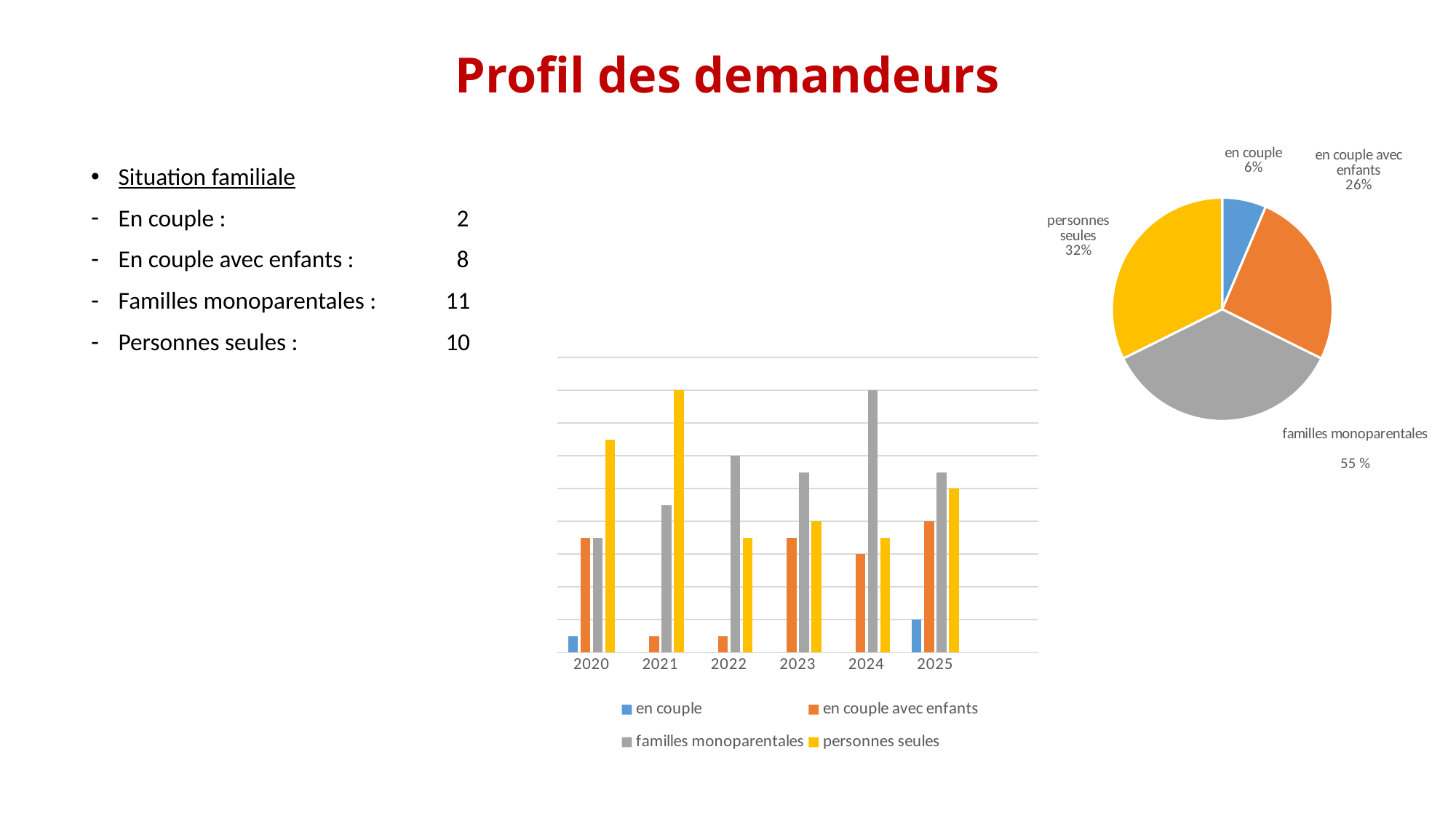
In the bar chart, in 2022, which is larger: 'familles monoparentales' or 'personnes seules'? familles monoparentales In the pie chart, what share is shown for 'en couple'? 6% In the pie chart, which category has the smallest slice? en couple What kind of chart is the chart on the right of the slide? pie chart In the bar chart, which series has the tallest bar in 2021? personnes seules In the bar chart, which series has the tallest bar in 2024? familles monoparentales In the pie chart, what share is shown for 'en couple avec enfants'? 26% In the pie chart, what share is shown for 'personnes seules'? 32% In the bar chart, how many years are shown on the x axis? 6 What kind of chart is the chart in the middle of the slide? bar chart In the pie chart, which category has the largest slice? familles monoparentales In the bar chart, how many series does the legend list? 4